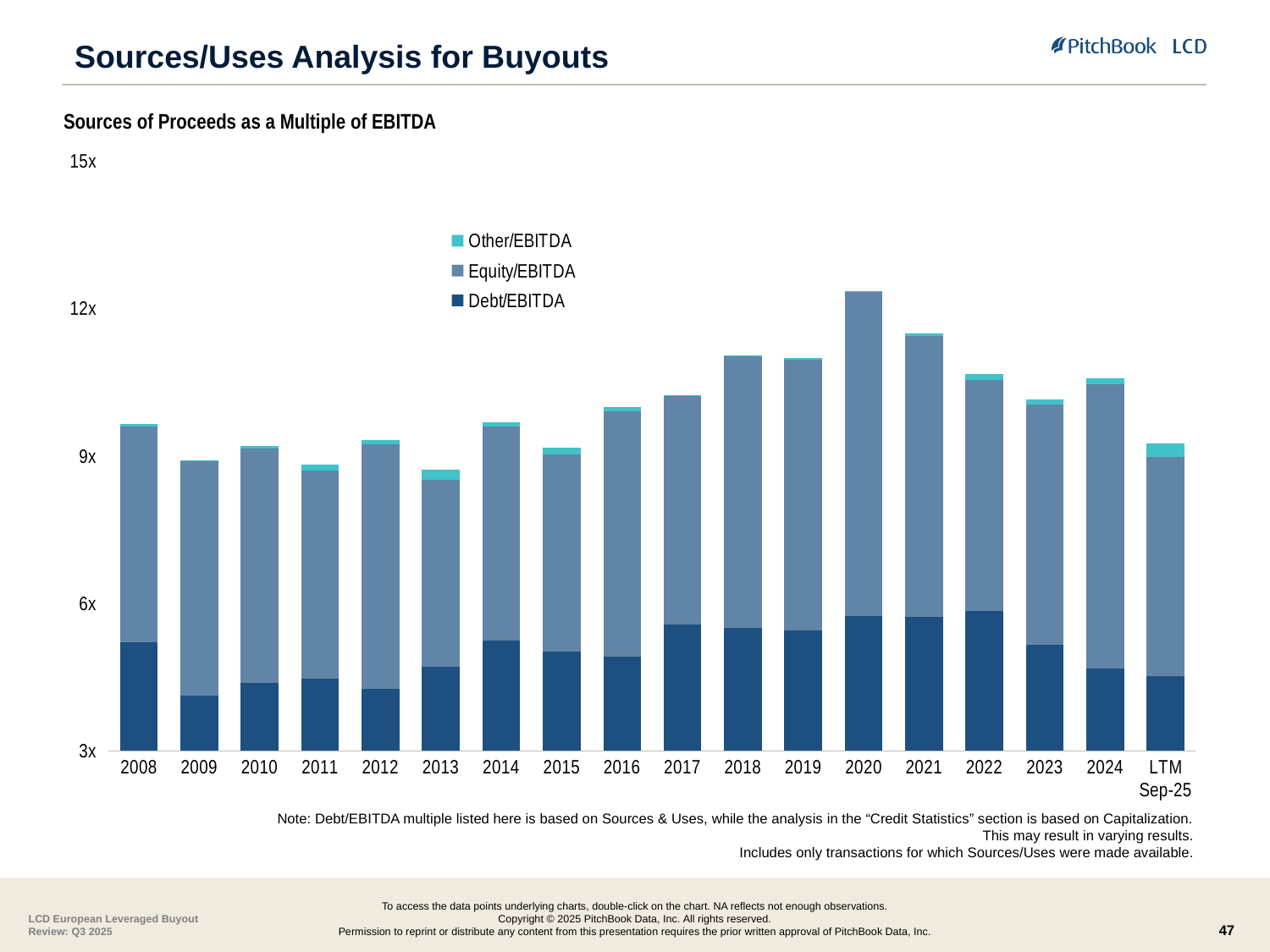
Is the total bar for LTM Sep-25 greater or less than 9x? greater Is the total bar for 2018 greater or less than 9x? greater Is the total bar for 2013 greater or less than 9x? less What is the title of the chart? Sources of Proceeds as a Multiple of EBITDA Which has the larger total bar, 2020 or 2008? 2020 How many categories are shown along the x axis? 18 Do the total bars generally rise or fall from 2013 to 2020? rise Which series is listed first in the legend? Other/EBITDA What kind of chart is shown on the slide? Stacked bar chart How many series does the chart legend list? 3 Which year has the tallest total bar? 2020